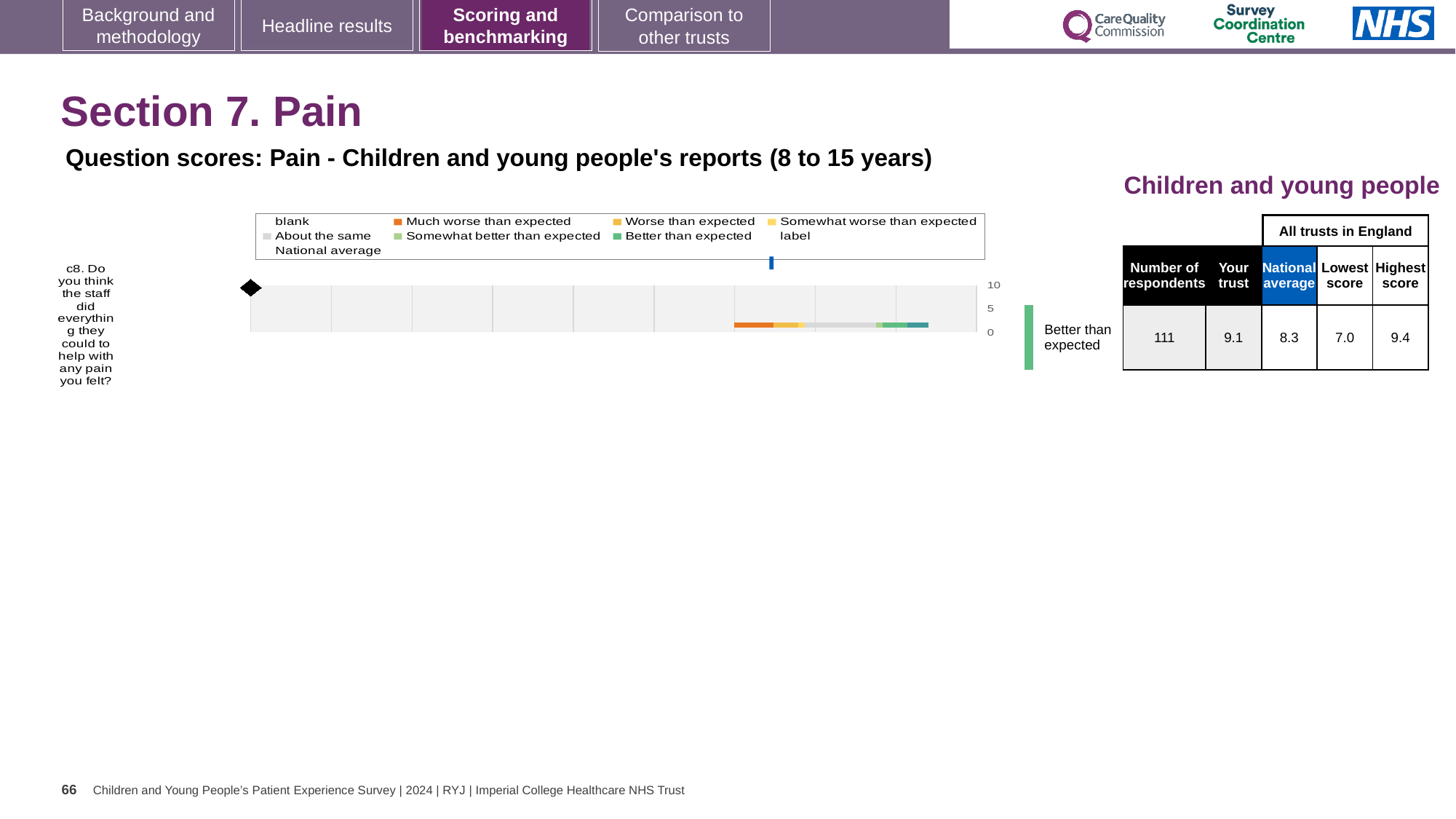
What is the highest value shown on the chart's numeric axis? 10 According to the table beside the chart, what is the 'Your trust' score for question c8? 9.1 How many questions (categories) are plotted on the chart? 1 How many respondents answered question c8, according to the table beside the chart? 111 According to the table beside the chart, what is the national average score for question c8? 8.3 According to the table beside the chart, what is the lowest score among all trusts in England for question c8? 7.0 What kind of chart is shown on the slide? bar chart What benchmark category is the trust's result for question c8 labelled as? Better than expected Which is larger for question c8: the 'Your trust' score or the national average? Your trust According to the table beside the chart, what is the highest score among all trusts in England for question c8? 9.4 What is the difference between the 'Your trust' score and the national average for question c8? 0.8 Which question is plotted on the chart? c8. Do you think the staff did everything they could to help with any pain you felt?